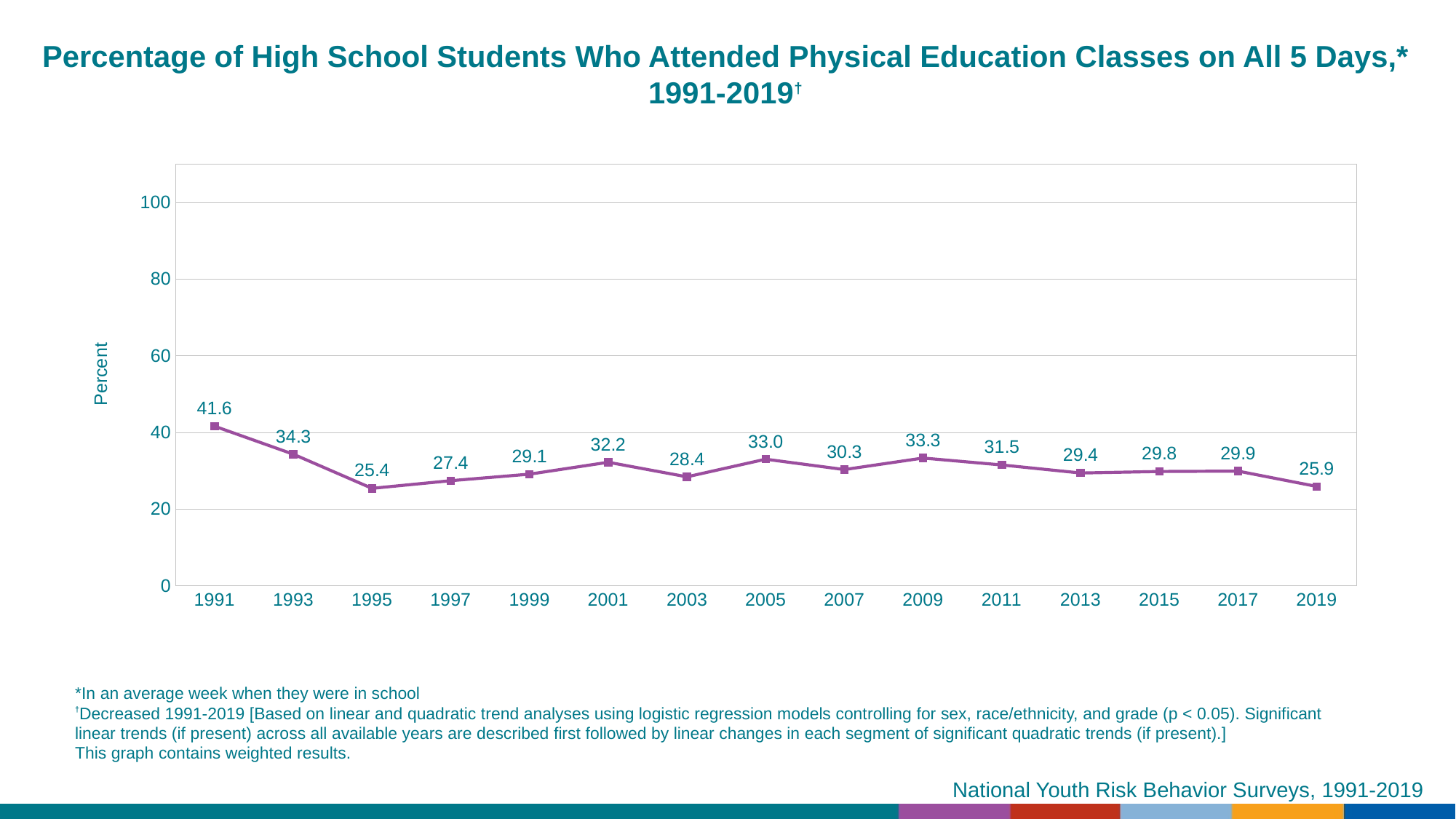
What value is shown for 2019? 25.9 What value is shown for 2009? 33.3 Which year has the larger value, 2005 or 2007? 2005 What was the percentage of high school students who attended physical education classes on all 5 days in 1991? 41.6 Which year has the lowest value on the chart? 1995 What kind of chart is shown on the slide? line chart How many years are plotted on the x axis? 15 Which year has the highest value on the chart? 1991 What is the difference between the values for 1991 and 2019? 15.7 What is the label of the y axis? Percent Is the value for 1991 greater or less than 40? greater What is the difference between the values for 2001 and 2003? 3.8